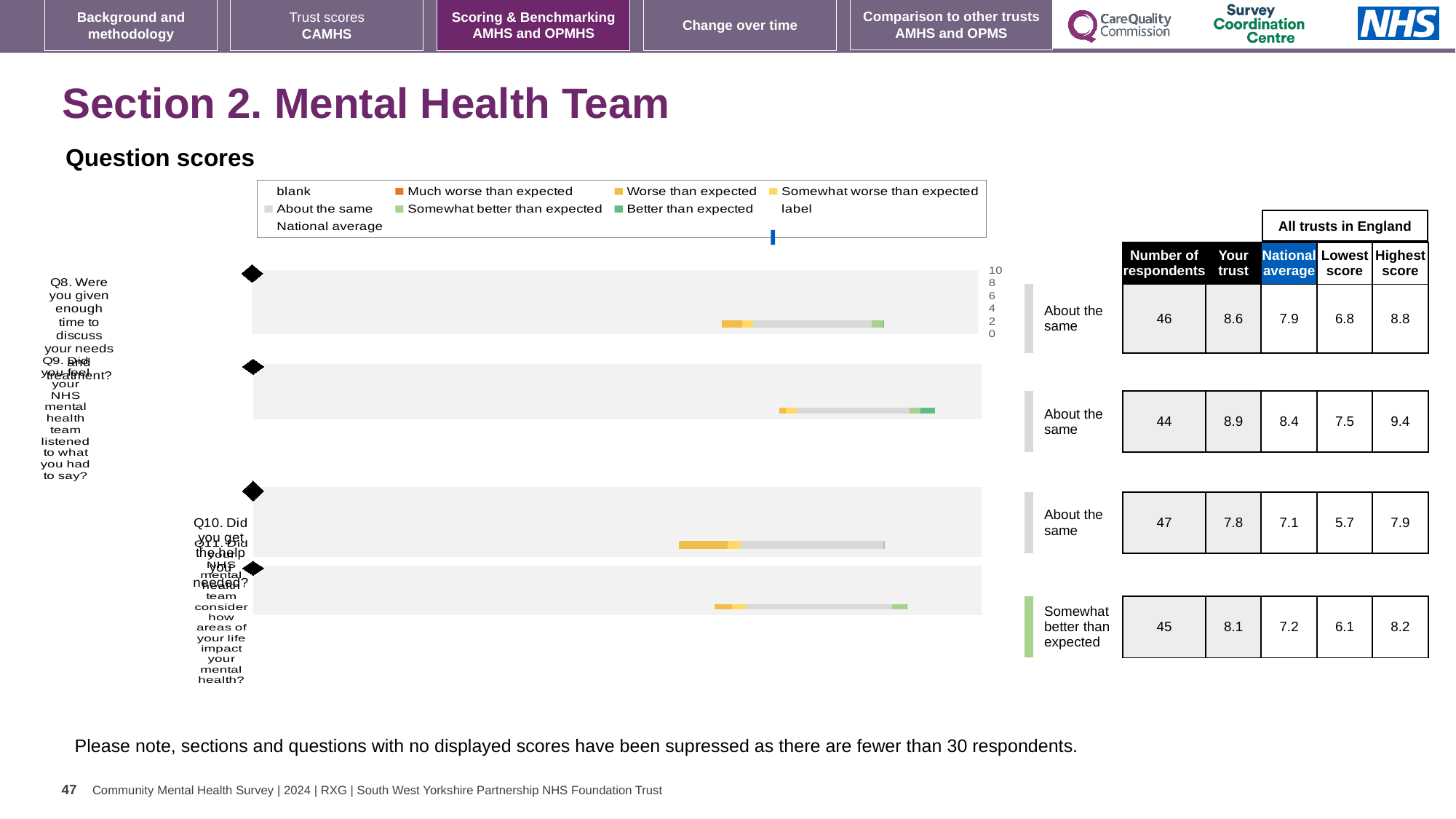
What is the national average score for Q8 (Were you given enough time to discuss your needs and treatment?)? 7.9 What is the highest score across all trusts in England for Q11? 8.2 What benchmark category is shown for Q11 (Did your NHS mental health team consider how areas of your life impact your mental health?)? Somewhat better than expected What is the 'Your trust' score for Q9 (Did you feel your NHS mental health team listened to what you had to say?)? 8.9 What is the lowest score across all trusts in England for Q10? 5.7 Which question has the lowest 'Your trust' score? Q10 How many questions (Q8 to Q11) are plotted in the question scores chart? 4 Which question has the highest 'Your trust' score? Q9 How many respondents answered Q10 (Did you get the help you needed?)? 47 Which is larger for Q11: the 'Your trust' score or the national average? Your trust What kind of chart is used to show the question scores on this slide? bar chart What is the difference between the 'Your trust' score and the national average for Q10? 0.7